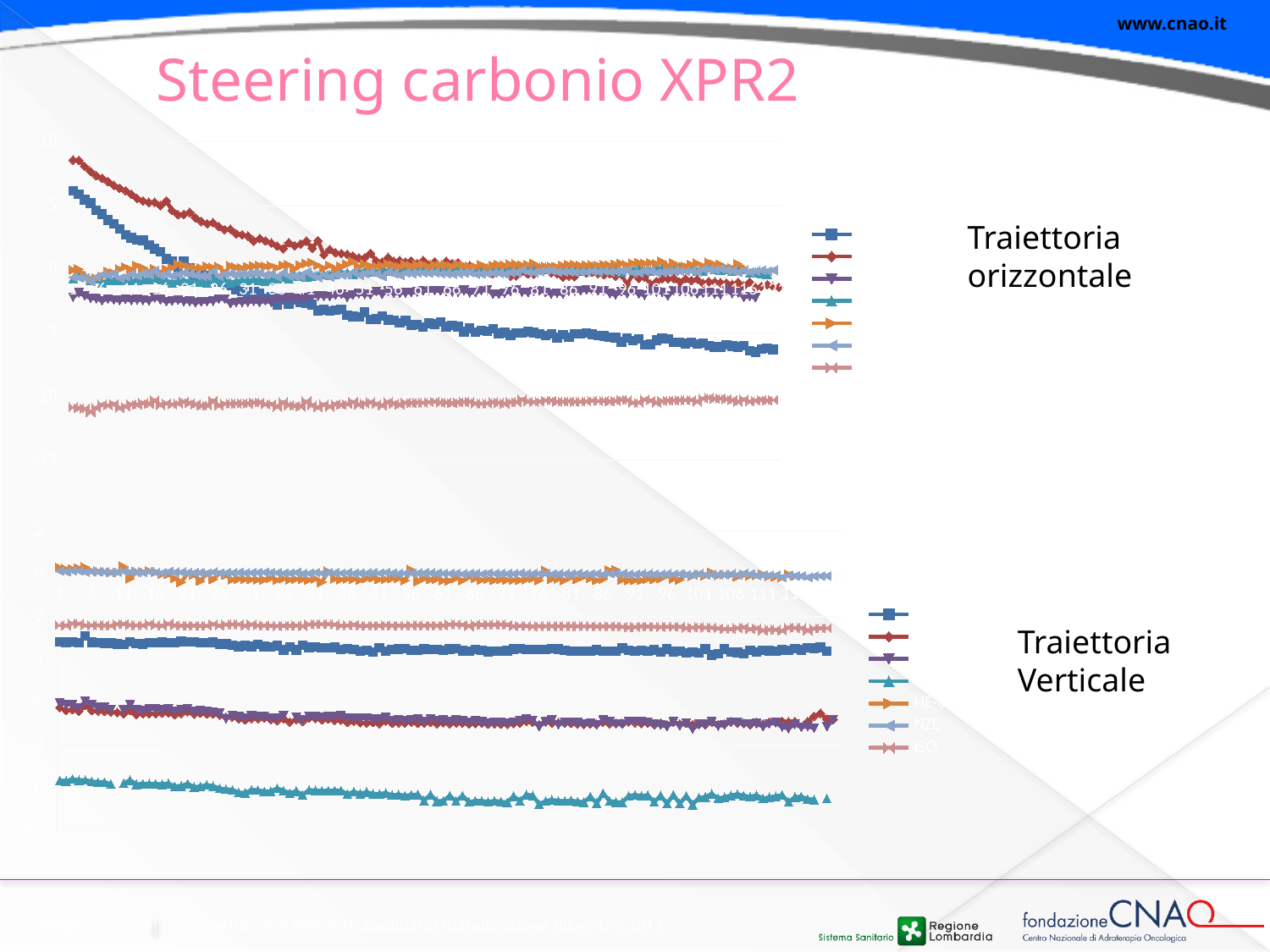
What kind of chart is the bottom chart (Traiettoria Verticale)? line chart How many series does the legend of the top chart (Traiettoria orizzontale) list? 7 What is the title of the slide containing the two charts? Steering carbonio XPR2 In the top chart (Traiettoria orizzontale), at x = 1, which is higher: the red diamond series or the blue square series? red diamond series In the top chart (Traiettoria orizzontale), does the red diamond series rise or fall along the x axis? fall In the bottom chart (Traiettoria Verticale), which series is lower: the teal triangle series or the pink x series? teal triangle series What kind of chart is the top chart (Traiettoria orizzontale)? line chart In the top chart (Traiettoria orizzontale), is the value of the pink x series greater or less than -5? less In the top chart (Traiettoria orizzontale), is the value of the red diamond series at x = 1 greater or less than 5? greater In the top chart (Traiettoria orizzontale), does the blue square series rise or fall along the x axis? fall How many series does the legend of the bottom chart (Traiettoria Verticale) list? 7 In the bottom chart (Traiettoria Verticale), is the value of the teal triangle series greater or less than -8? less